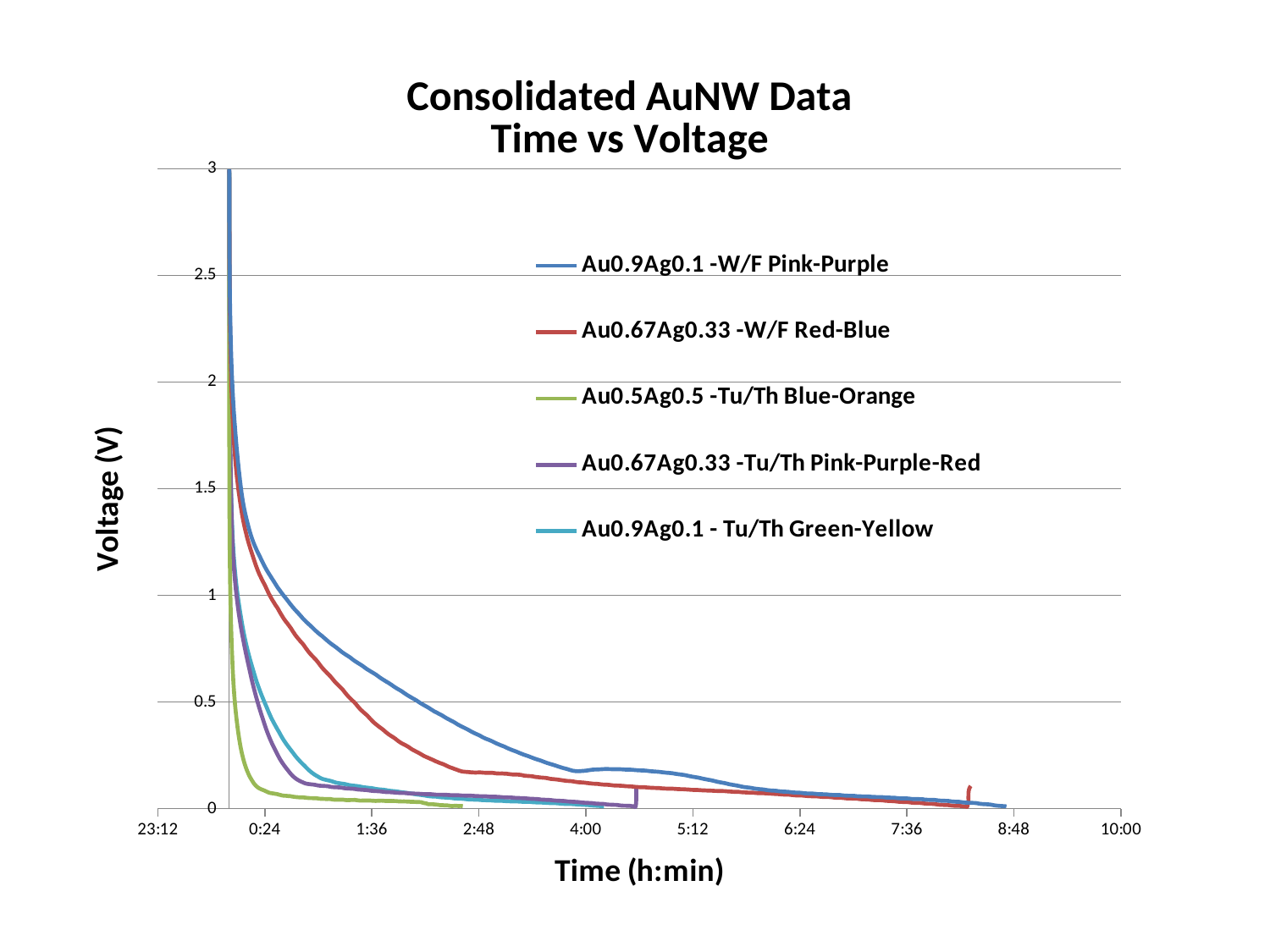
Which series is plotted in green? Au0.5Ag0.5 -Tu/Th Blue-Orange At 0:24, which series has the higher voltage, Au0.67Ag0.33 -W/F Red-Blue or Au0.5Ag0.5 -Tu/Th Blue-Orange? Au0.67Ag0.33 -W/F Red-Blue At 1:36, which series has the higher voltage, Au0.9Ag0.1 -W/F Pink-Purple or Au0.5Ag0.5 -Tu/Th Blue-Orange? Au0.9Ag0.1 -W/F Pink-Purple At 1:36, is the voltage for Au0.9Ag0.1 -W/F Pink-Purple greater or less than 0.5? greater Do the voltage values rise or fall as time increases along the x axis? fall Which series extends furthest along the time axis before ending? Au0.9Ag0.1 -W/F Pink-Purple How many series does the legend list? 5 Which series drops to near zero voltage and ends earliest in time? Au0.5Ag0.5 -Tu/Th Blue-Orange What is the title of the chart? Consolidated AuNW Data Time vs Voltage At 2:48, is the voltage for Au0.67Ag0.33 -W/F Red-Blue greater or less than 0.5? less What kind of chart is shown on the slide? line chart At 5:12, is the voltage for Au0.9Ag0.1 -W/F Pink-Purple greater or less than 0.5? less